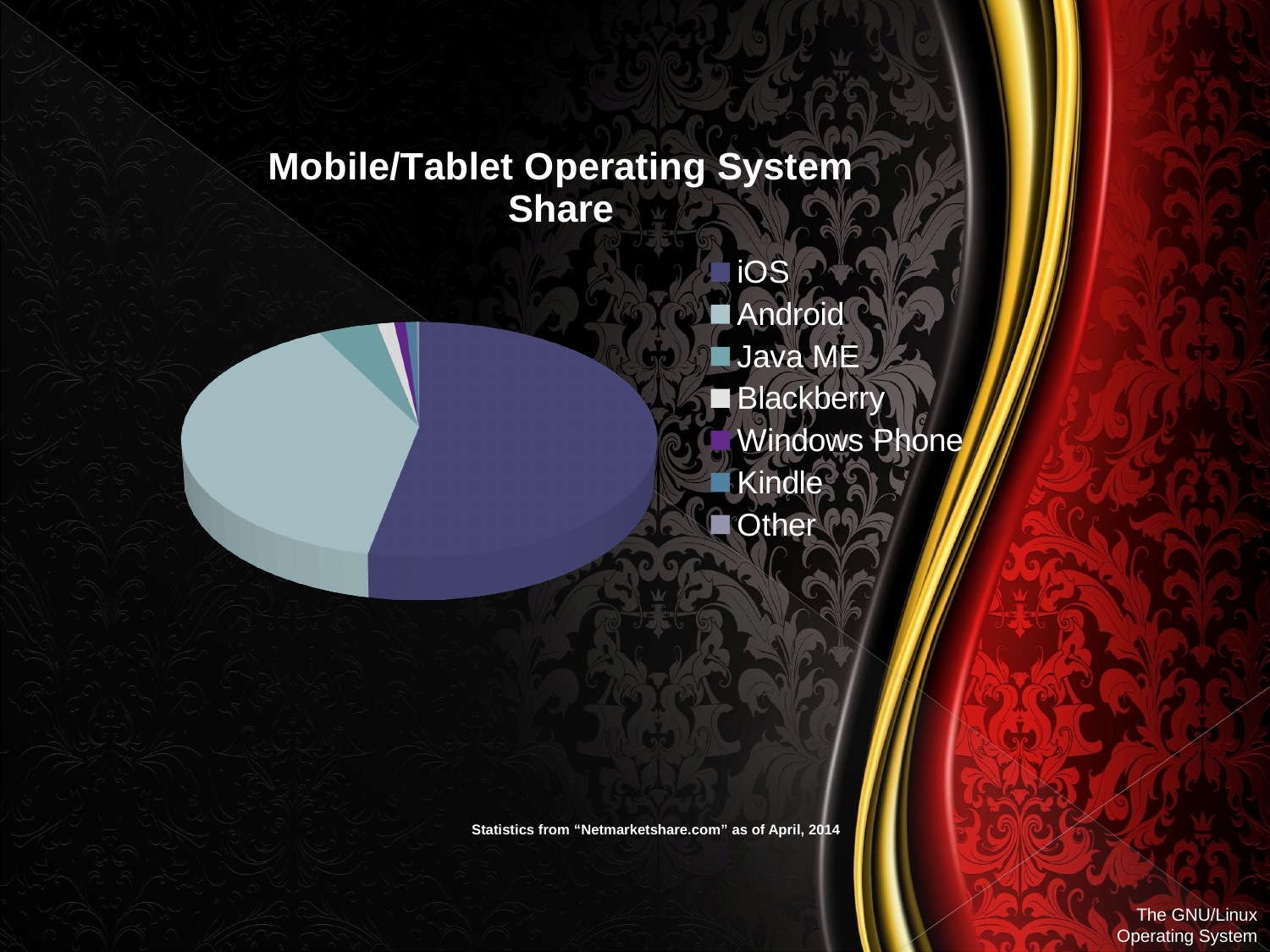
Which slice is larger, Android or Blackberry? Android What is the title of the chart? Mobile/Tablet Operating System Share Which slice is larger, iOS or Android? iOS Which slice is larger, Java ME or Windows Phone? Java ME Which operating system is listed first in the legend? iOS Which operating system has the largest slice of the pie? iOS How many categories does the legend of the pie chart list? 7 What kind of chart is shown on the slide? Pie chart